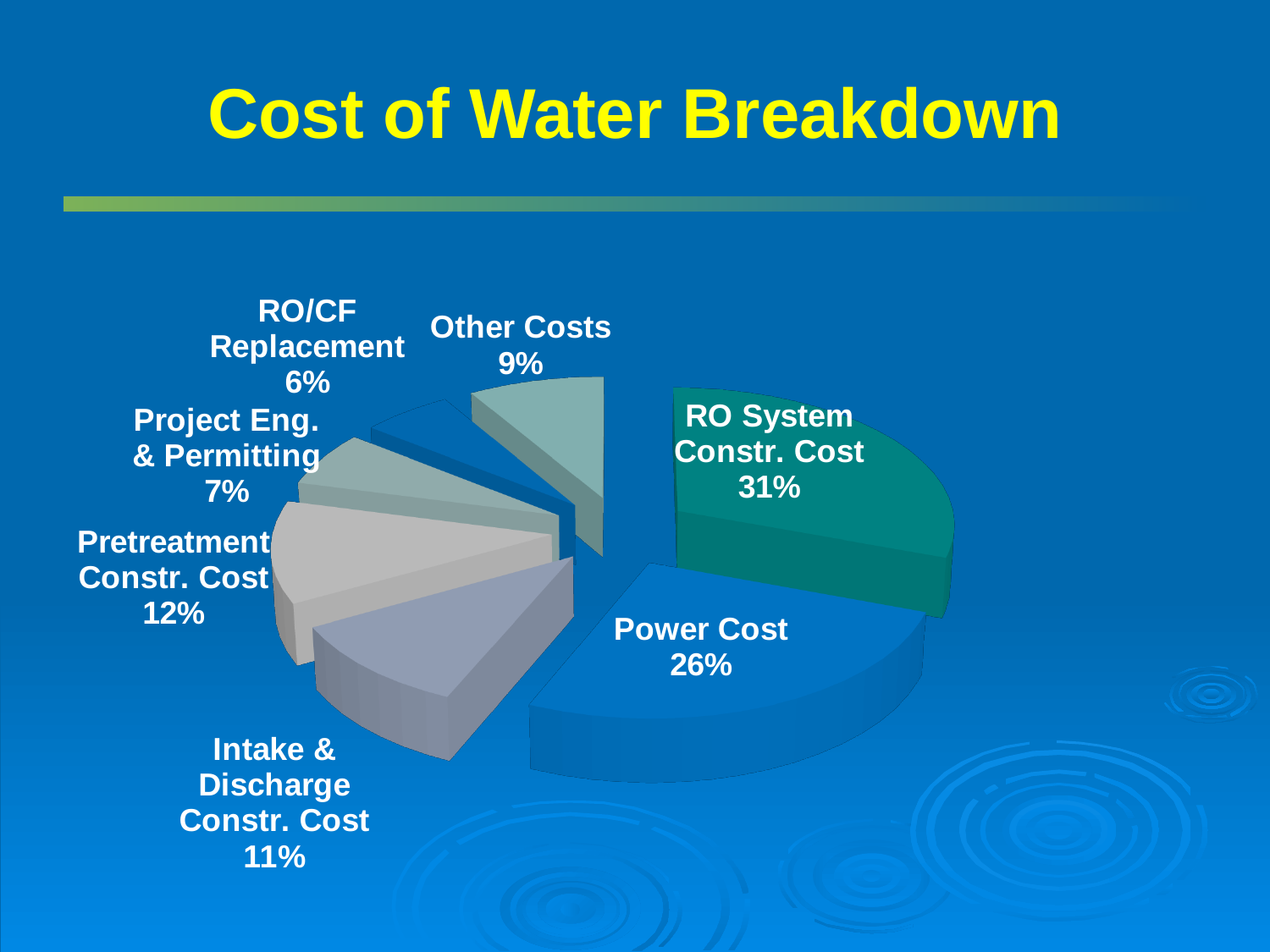
What share of the cost is Pretreatment Constr. Cost? 12% What is the title of the chart? Cost of Water Breakdown Which is larger, Other Costs or Project Eng. & Permitting? Other Costs What kind of chart is shown on the slide? Pie chart What share of the cost is RO/CF Replacement? 6% Which category has the largest share of the pie? RO System Constr. Cost What share of the cost is Intake & Discharge Constr. Cost? 11% What is the difference in percentage points between RO System Constr. Cost and Power Cost? 5 percentage points Which category has the smallest share of the pie? RO/CF Replacement What share of the cost is RO System Constr. Cost? 31% What share of the cost is Power Cost? 26% How many slices does the pie chart have? 7